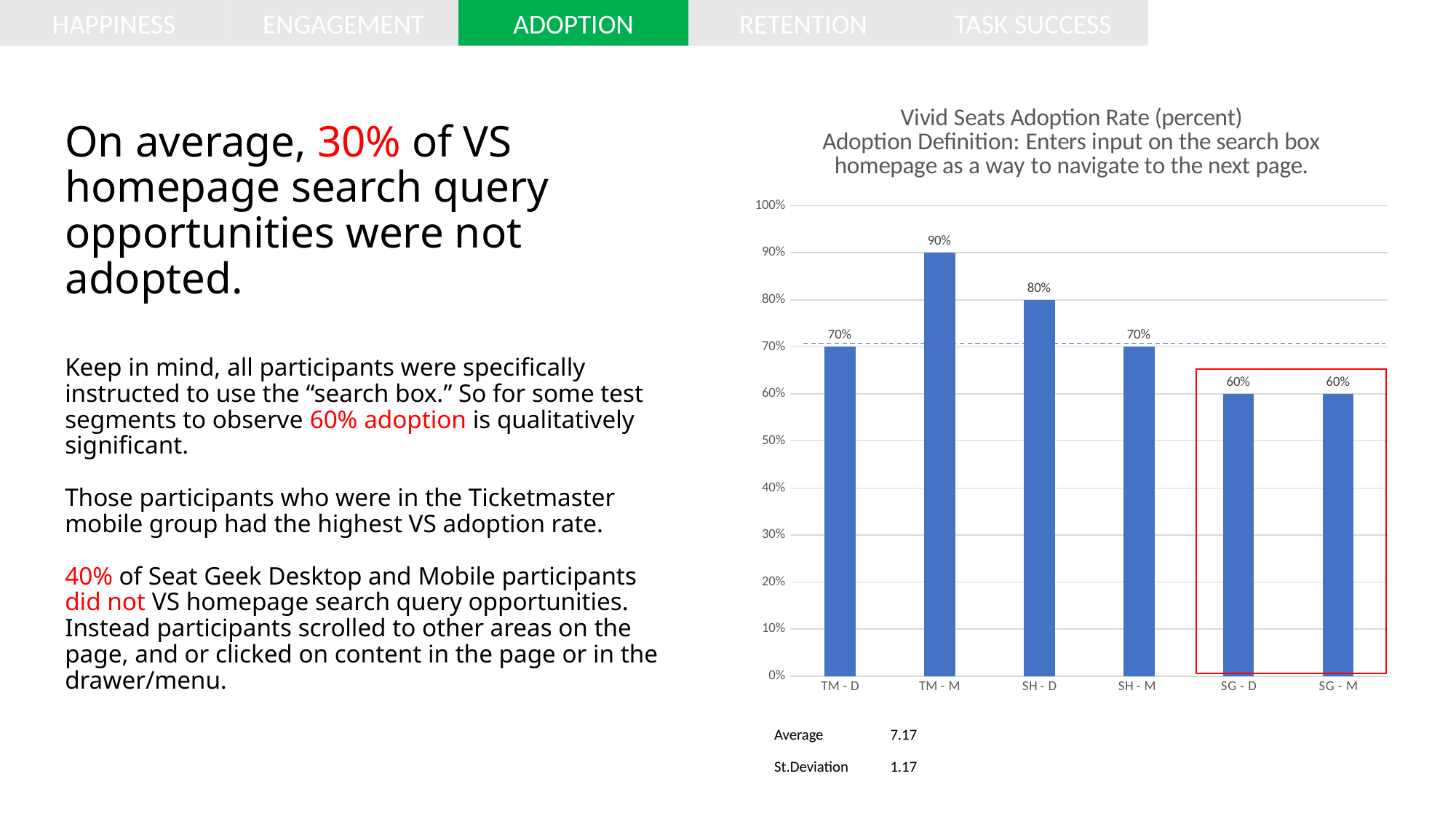
Which two bars are enclosed by the red rectangle on the chart? SG - D and SG - M What is the difference between the adoption rates of TM - M and SH - D? 10% What is the adoption rate for SH - D? 80% What is the adoption rate for TM - M? 90% Which category has the highest adoption rate? TM - M What is the first line of the chart's title? Vivid Seats Adoption Rate (percent) What is the difference between the adoption rates of SH - D and SG - D? 20% What is the adoption rate for SG - M? 60% Which has a higher adoption rate, TM - D or SH - D? SH - D What kind of chart is shown on the slide? bar chart How many categories are shown on the x axis of the chart? 6 Is the adoption rate for SG - D greater or less than 70%? less